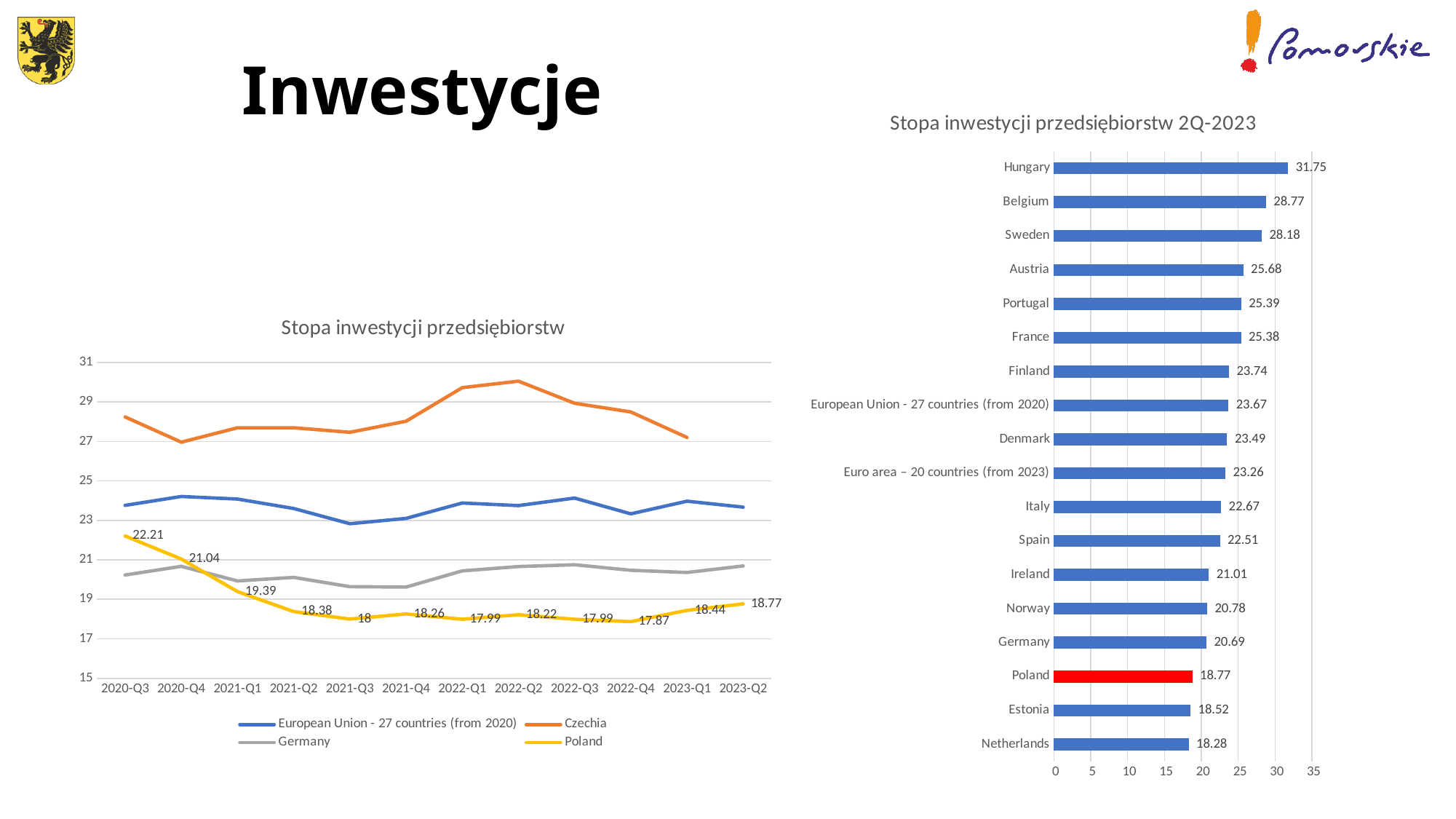
In the line chart 'Stopa inwestycji przedsiębiorstw', which series has the highest values across all quarters? Czechia In the chart 'Stopa inwestycji przedsiębiorstw 2Q-2023', which bar is coloured red? Poland In the chart 'Stopa inwestycji przedsiębiorstw 2Q-2023', what is the difference between Belgium and Sweden? 0.59 In the chart 'Stopa inwestycji przedsiębiorstw 2Q-2023', what is the value for Hungary? 31.75 In the line chart 'Stopa inwestycji przedsiębiorstw', what is the difference between Poland's value in 2023-Q2 and 2022-Q4? 0.9 What kind of chart is 'Stopa inwestycji przedsiębiorstw 2Q-2023'? bar chart In the line chart 'Stopa inwestycji przedsiębiorstw', how many series does the legend list? 4 In the line chart 'Stopa inwestycji przedsiębiorstw', what is the value for Poland in 2020-Q3? 22.21 In the chart 'Stopa inwestycji przedsiębiorstw 2Q-2023', how many categories are shown? 18 In the line chart 'Stopa inwestycji przedsiębiorstw', is the value for Czechia in 2022-Q2 greater or less than 29? greater In the chart 'Stopa inwestycji przedsiębiorstw 2Q-2023', which country has the lowest value? Netherlands In the chart 'Stopa inwestycji przedsiębiorstw 2Q-2023', which is larger: Ireland or Norway? Ireland